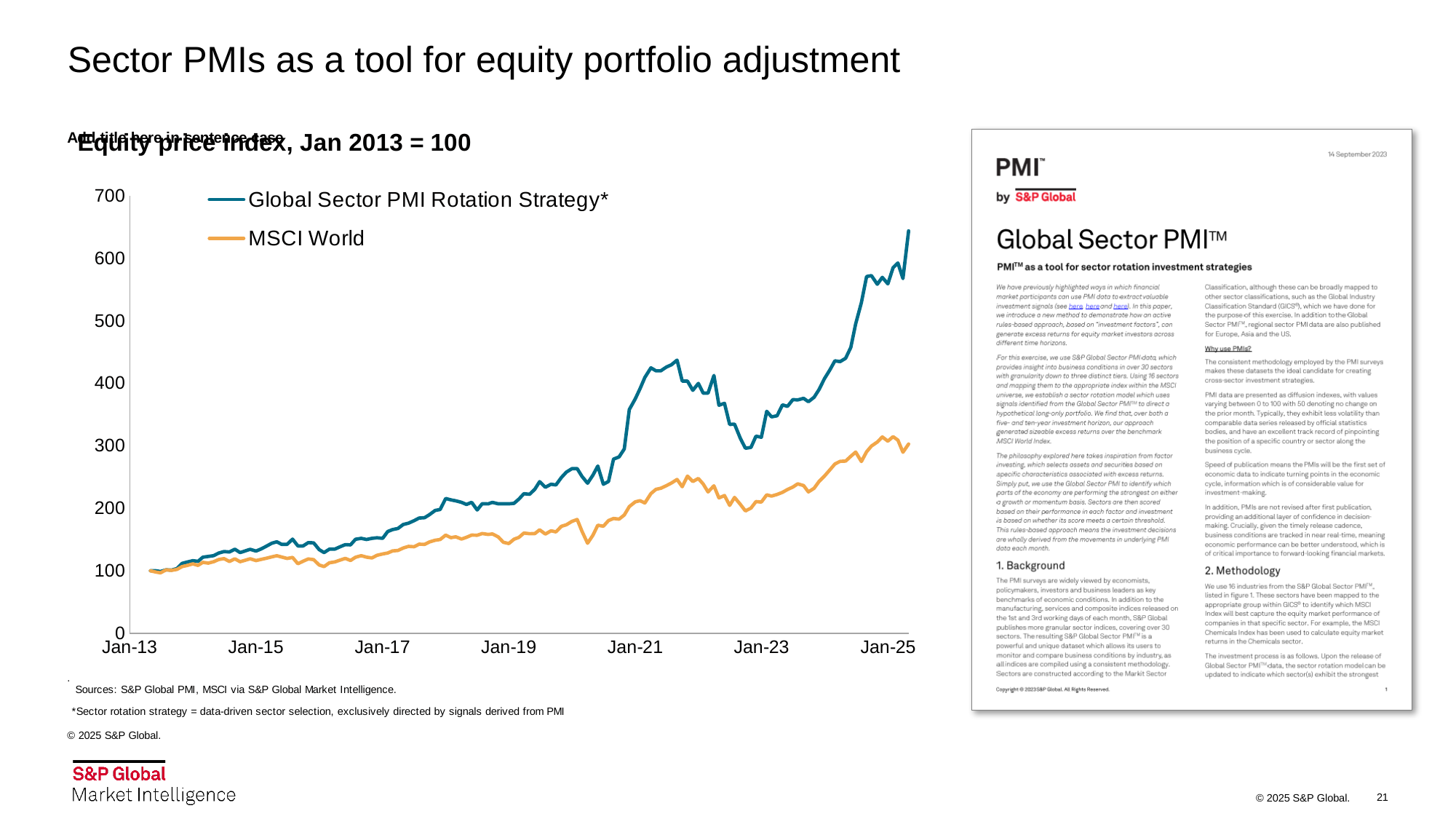
Is the final value of the Global Sector PMI Rotation Strategy line, at the right end of the chart, greater or less than 600? greater What kind of chart is shown on the slide? Line chart Does the MSCI World line rise or fall overall from Jan-13 to Jan-25? Rise Is the value of the Global Sector PMI Rotation Strategy at Jan-21 greater or less than 300? greater Which series is higher at Jan-23, Global Sector PMI Rotation Strategy or MSCI World? Global Sector PMI Rotation Strategy What colour is the MSCI World line in the chart? Orange How many date labels are shown on the chart's x axis? 7 What are the two series named in the chart's legend? Global Sector PMI Rotation Strategy* and MSCI World Is the value of MSCI World at Jan-25 greater or less than 400? less Does the Global Sector PMI Rotation Strategy line rise or fall overall from Jan-13 to Jan-25? Rise How many series does the chart's legend list? 2 What is the value of both series at Jan-13, the start of the chart? 100